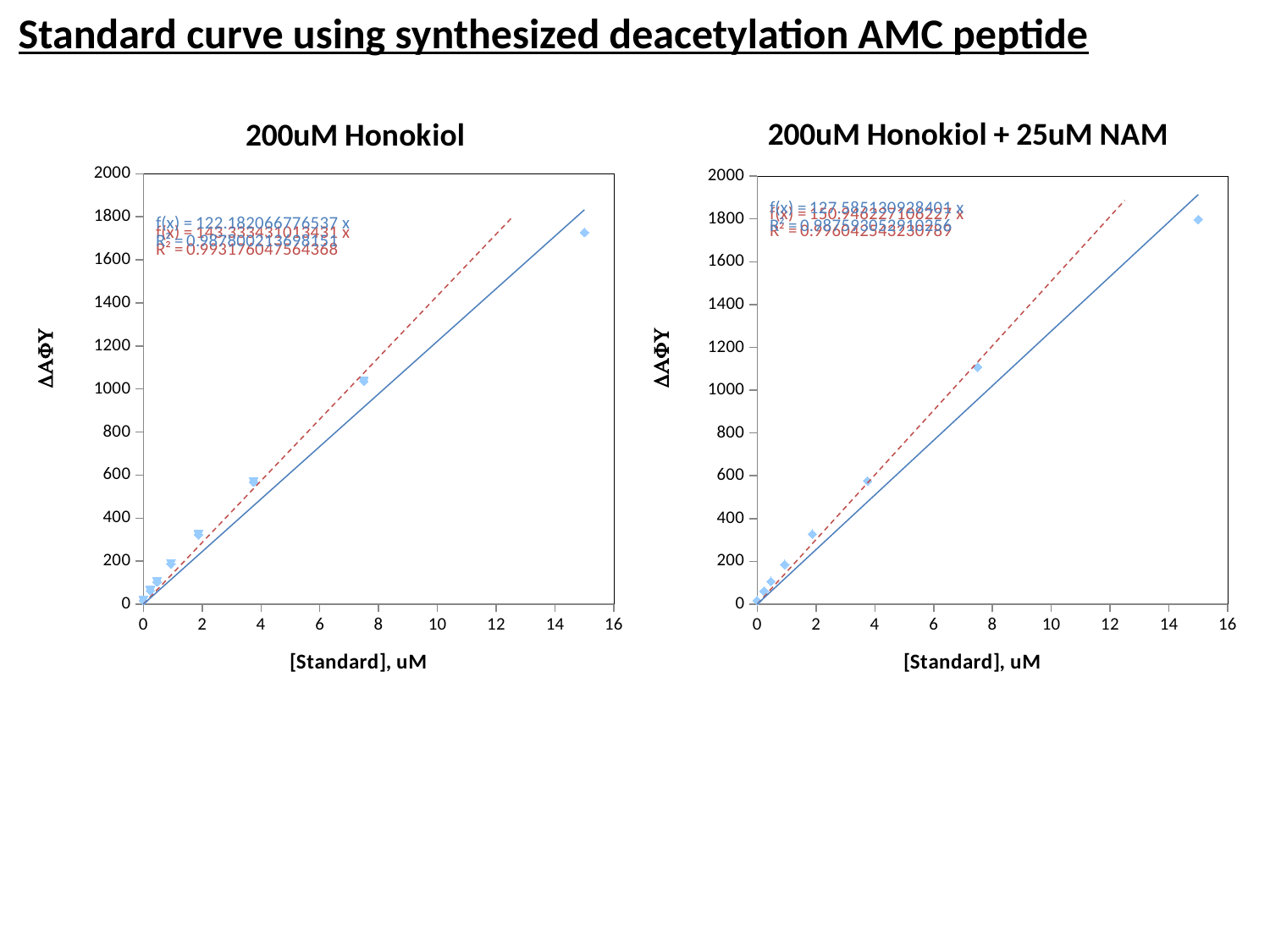
In the '200uM Honokiol' chart, which plotted point has the highest value? the point at 15 uM What kind of chart is the left chart titled '200uM Honokiol'? scatter chart In the '200uM Honokiol + 25uM NAM' chart, is the value for the point near 4 uM greater or less than 400? greater In the '200uM Honokiol' chart, is the value for the point at 15 uM greater or less than 1800? less What is the maximum value shown on the y-axis of the right chart? 2000 In the '200uM Honokiol' chart, do the plotted values rise or fall as [Standard] increases? rise What is the title of the right chart? 200uM Honokiol + 25uM NAM In the '200uM Honokiol' chart, is the value for the point near 7.5 uM greater or less than 800? greater In the '200uM Honokiol + 25uM NAM' chart, which point has the larger value: the one at 15 uM or the one near 7.5 uM? the one at 15 uM What is the x-axis label on the left chart? [Standard], uM